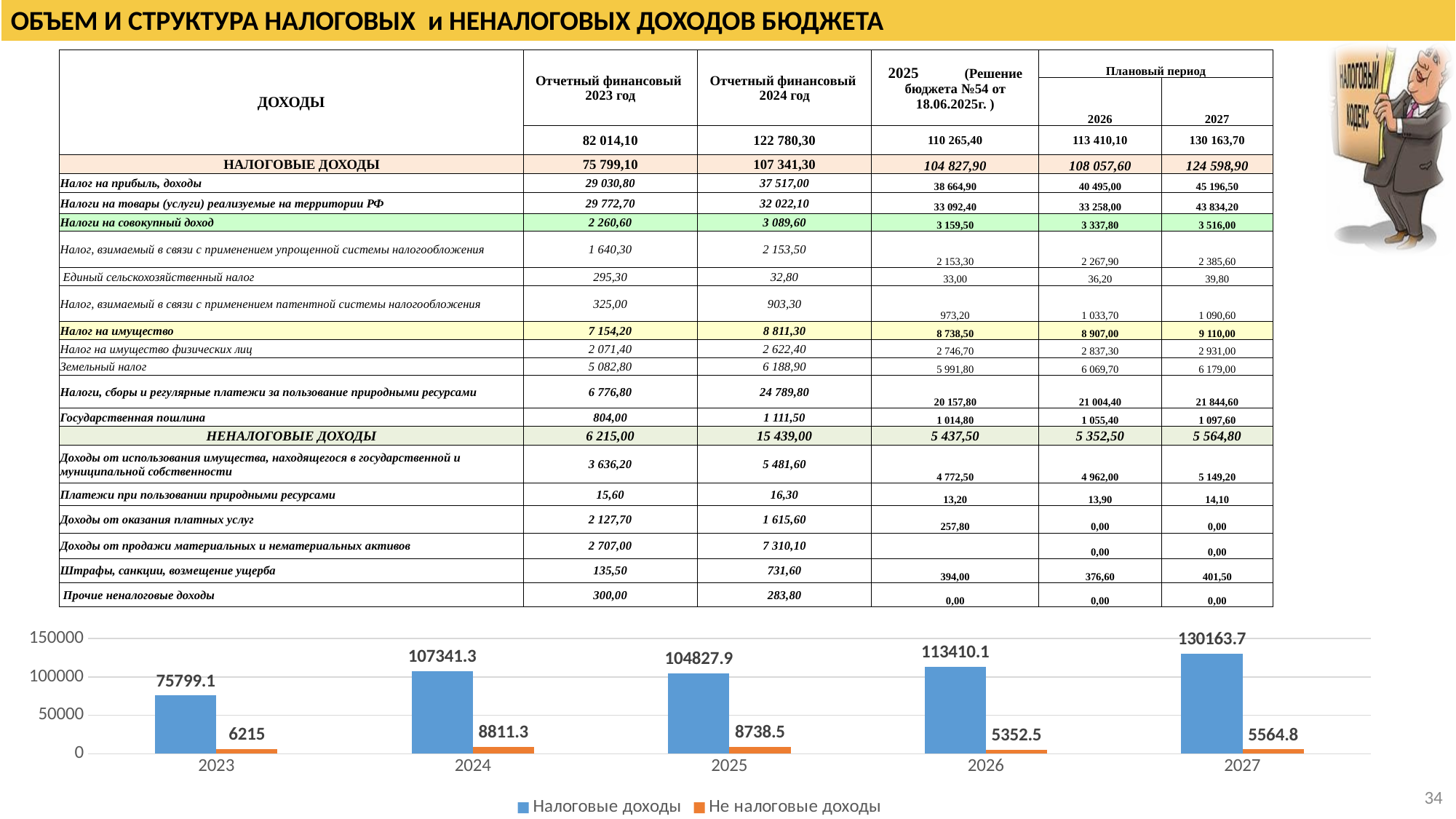
In the bar chart, what is the value of Не налоговые доходы for 2023? 6215 How many years are shown on the x axis of the bar chart? 5 In the bar chart, which year has the lowest value for Не налоговые доходы? 2026 In the bar chart, is Не налоговые доходы larger in 2024 or in 2027? 2024 In the bar chart, which year has the highest value for Налоговые доходы? 2027 What kind of chart is shown at the bottom of the slide? bar chart In the bar chart, which colour represents Не налоговые доходы? orange In the bar chart, what is the value of Налоговые доходы for 2025? 104827.9 In the bar chart, what is the value of Налоговые доходы for 2027? 130163.7 In the bar chart, is the value of Налоговые доходы for 2023 greater or less than 100000? less In the bar chart, what is the difference between Налоговые доходы in 2024 and in 2023? 31542.2 How many series does the legend of the bar chart list? 2